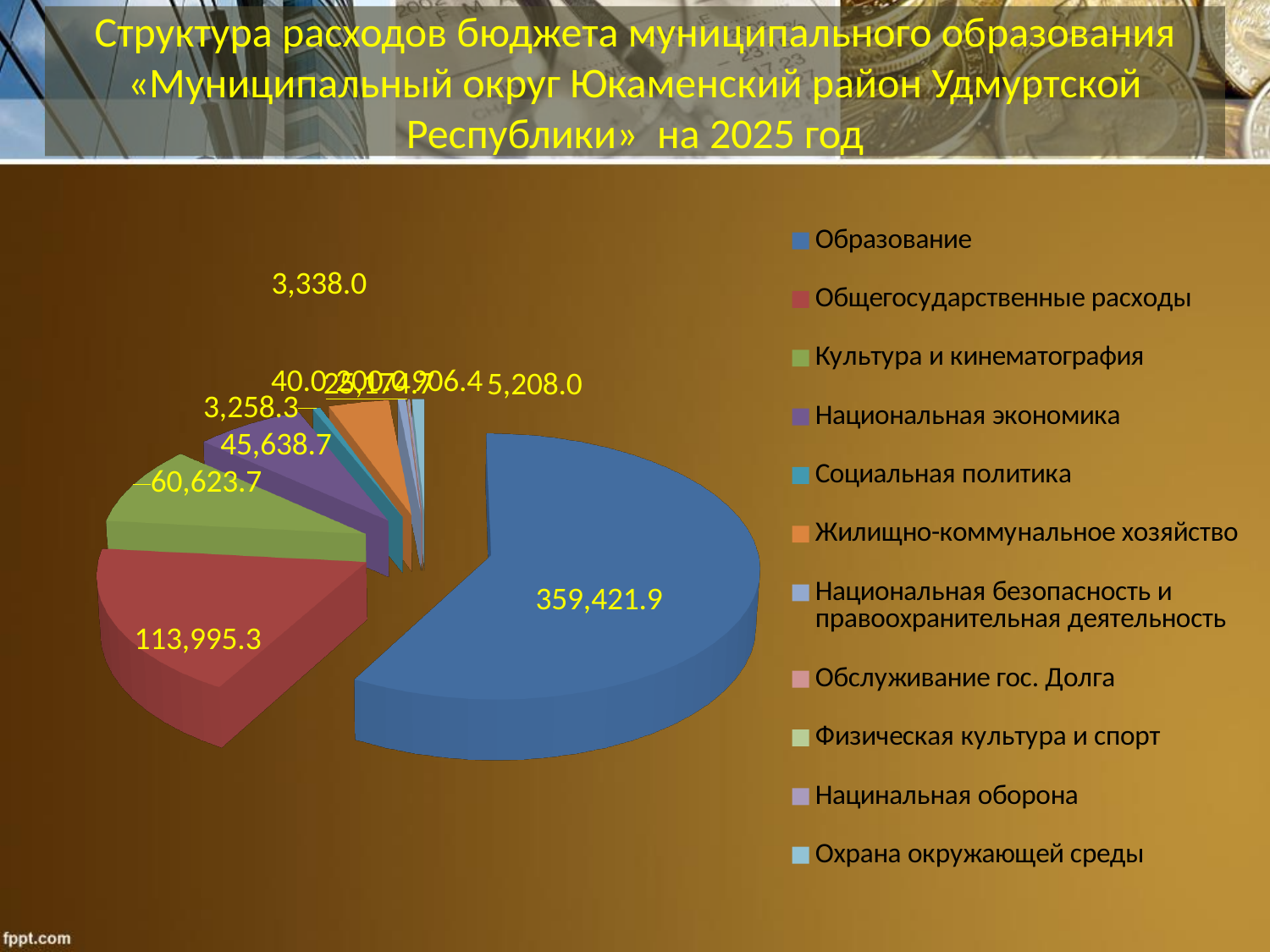
Which is larger, Общегосударственные расходы or Культура и кинематография? Общегосударственные расходы What is the difference between the values for Культура и кинематография and Национальная экономика? 14,985.0 Which category has the largest slice of the pie? Образование Which year does the chart title refer to? 2025 What is the value for Общегосударственные расходы? 113,995.3 How many categories does the legend list? 11 What is the value for Культура и кинематография? 60,623.7 What is the difference between the values for Образование and Общегосударственные расходы? 245,426.6 What is the value for Образование? 359,421.9 What kind of chart is shown on the slide? pie chart What is the value for Национальная экономика? 45,638.7 Which colour represents Образование in the pie chart? blue